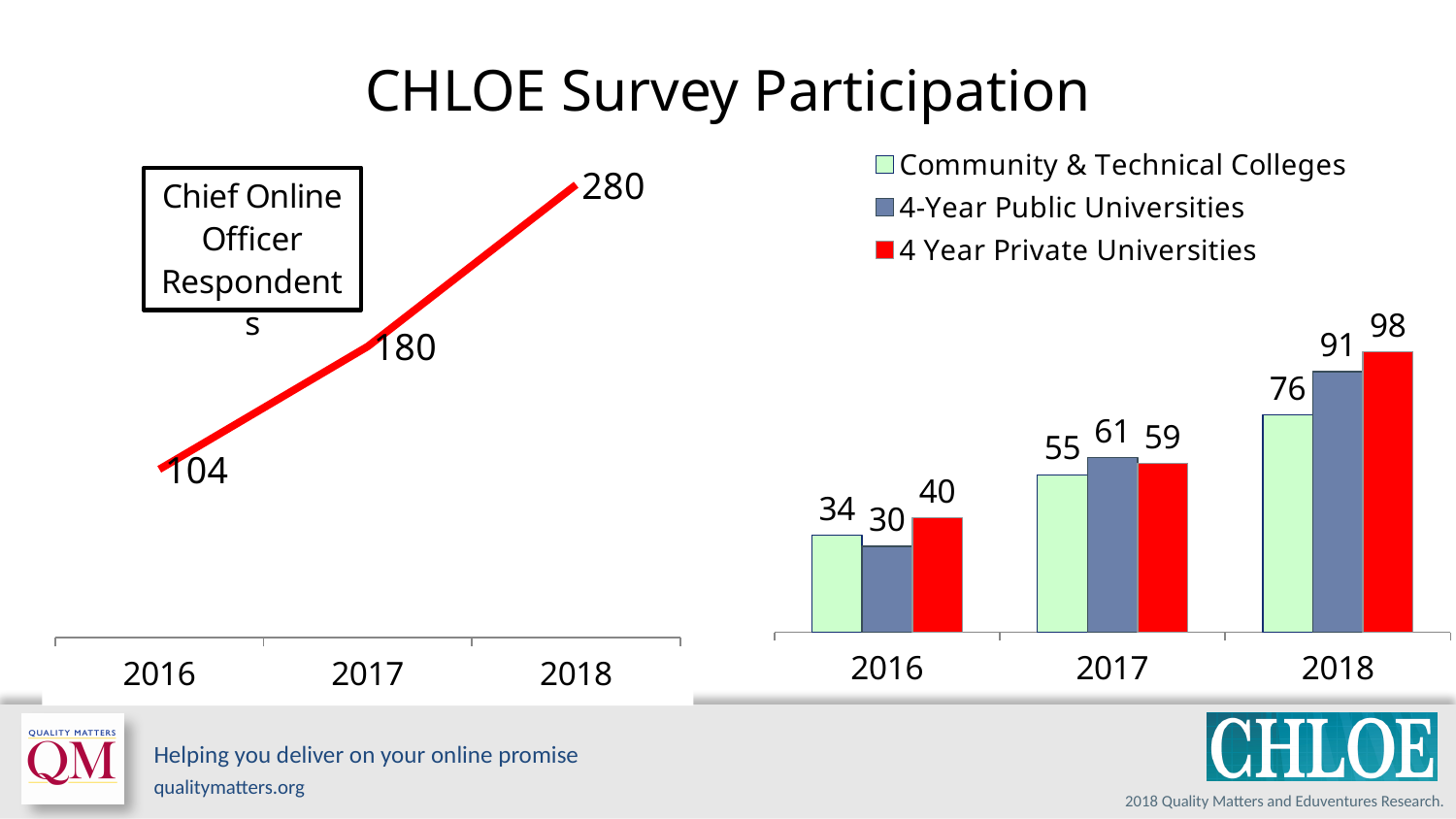
In the bar chart on the right, which series has the lowest value in 2016? 4-Year Public Universities In the bar chart on the right, which series has the highest value in 2018? 4 Year Private Universities In the line chart on the left, what is the value for 2018? 280 In the bar chart on the right, what is the value for 4 Year Private Universities in 2016? 40 What kind of chart is the chart on the left? line chart How many series does the legend of the bar chart on the right list? 3 In the line chart on the left, what is the value for 2016? 104 In the bar chart on the right, what is the value for 4-Year Public Universities in 2017? 61 In the bar chart on the right, which is larger in 2017: Community & Technical Colleges or 4 Year Private Universities? 4 Year Private Universities In the line chart on the left, what is the difference between the 2018 and 2017 values? 100 In the line chart on the left, do the values rise or fall from 2016 to 2018? rise In the bar chart on the right, what is the difference between the Community & Technical Colleges values for 2018 and 2016? 42